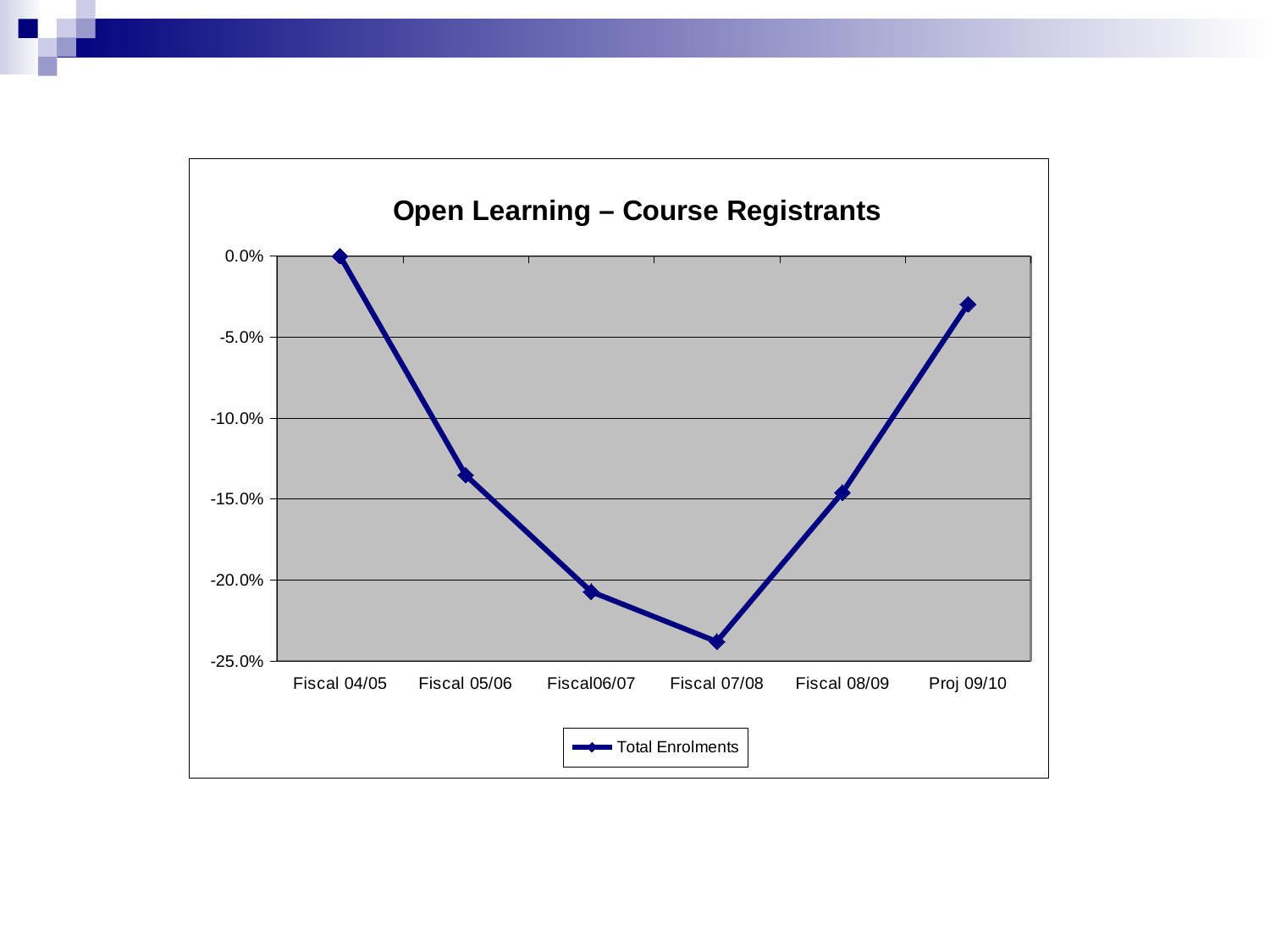
Is the value for Fiscal 07/08 greater or less than -20.0%? less Which period has the lowest value? Fiscal 07/08 How many fiscal periods are plotted along the x axis? 6 What type of chart is shown on the slide? Line chart Is the value for Proj 09/10 greater or less than -5.0%? greater Which is larger, the value for Fiscal06/07 or the value for Fiscal 07/08? Fiscal06/07 How do the values change from Fiscal 04/05 to Proj 09/10? They fall until Fiscal 07/08, then rise What is the title of the chart? Open Learning – Course Registrants What is the name of the series shown in the legend? Total Enrolments What is the value for Fiscal 04/05? 0.0% Which period has the highest value? Fiscal 04/05 How many series does the legend list? 1